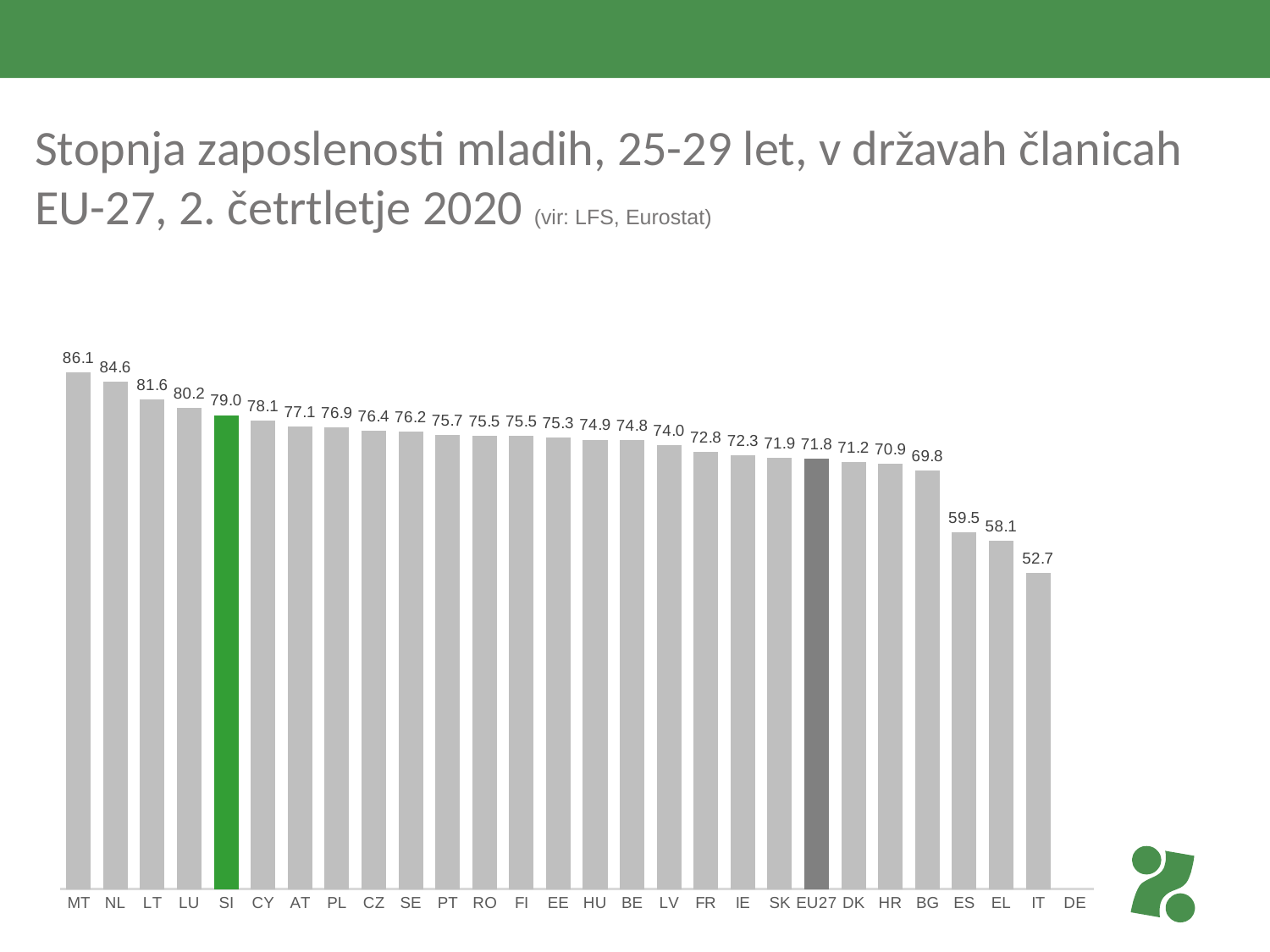
What is the value for IT? 52.7 Which country has the highest value? MT What is the difference between the values for SI and EU27? 7.2 Which country with a plotted bar has the lowest value? IT Which country's bar is coloured green? SI What kind of chart is shown on the slide? bar chart Do the values rise or fall from left to right along the x axis? fall What is the value for FR? 72.8 What is the value for EU27? 71.8 Which is larger, the value for NL or the value for LT? NL What is the value for SI? 79.0 What is the difference between the values for MT and IT? 33.4